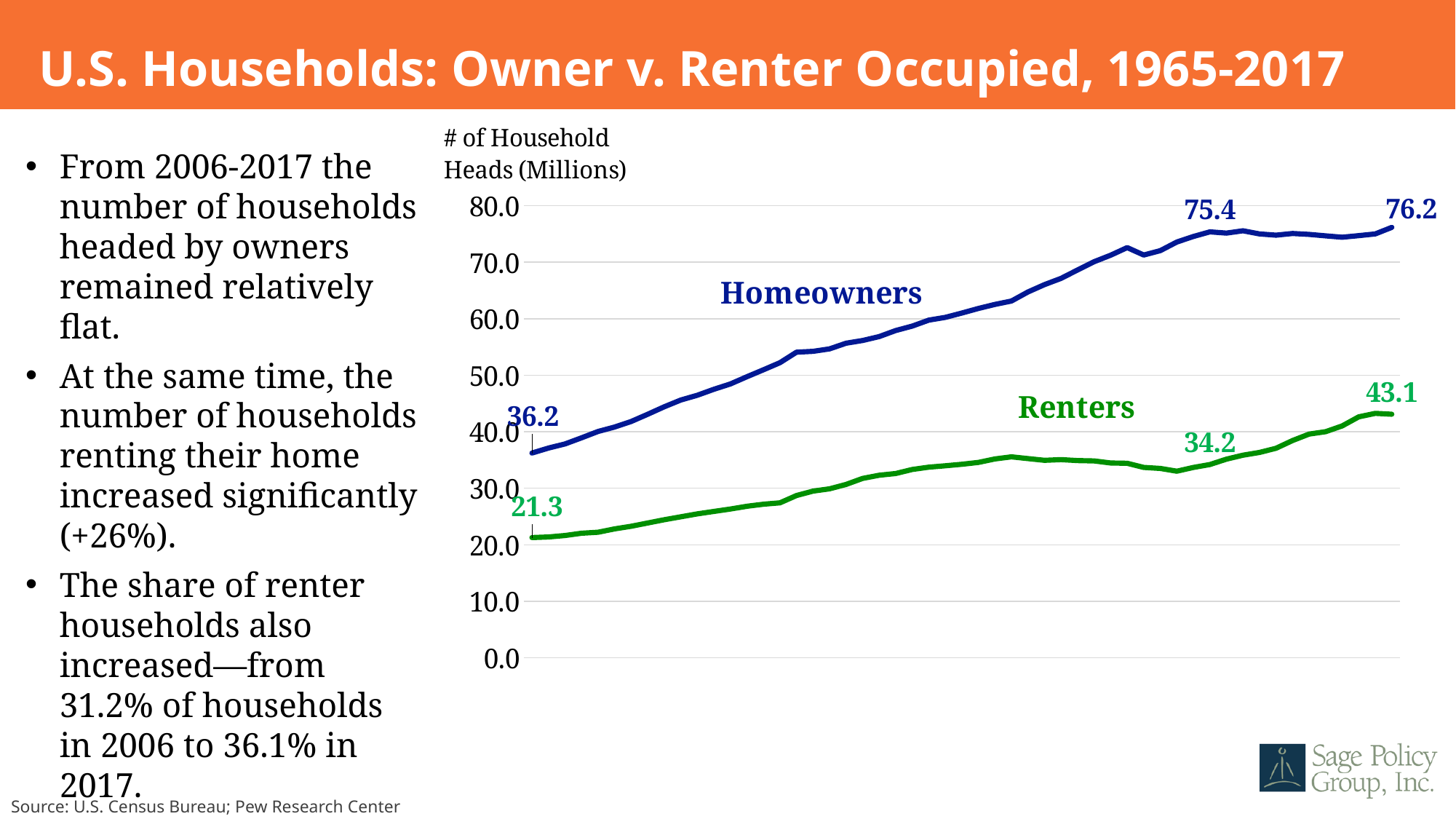
What is the label on the vertical axis of the chart? # of Household Heads (Millions) How many data series are plotted on the chart? 2 What type of chart is shown on the slide? line chart What is the first labeled value on the Homeowners line? 36.2 What is the last labeled value on the Homeowners line? 76.2 By how much did the Renters line increase from its first labeled value (21.3) to its last labeled value (43.1)? 21.8 What is the first labeled value on the Renters line? 21.3 Which series has the higher value at the right end of the chart, Homeowners or Renters? Homeowners What is the difference between the two labeled Homeowners values 76.2 and 75.4? 0.8 Does the Renters line generally rise or fall from left to right across the chart? rise What is the difference between the final labeled Homeowners value (76.2) and the final labeled Renters value (43.1)? 33.1 What is the last labeled value on the Renters line? 43.1